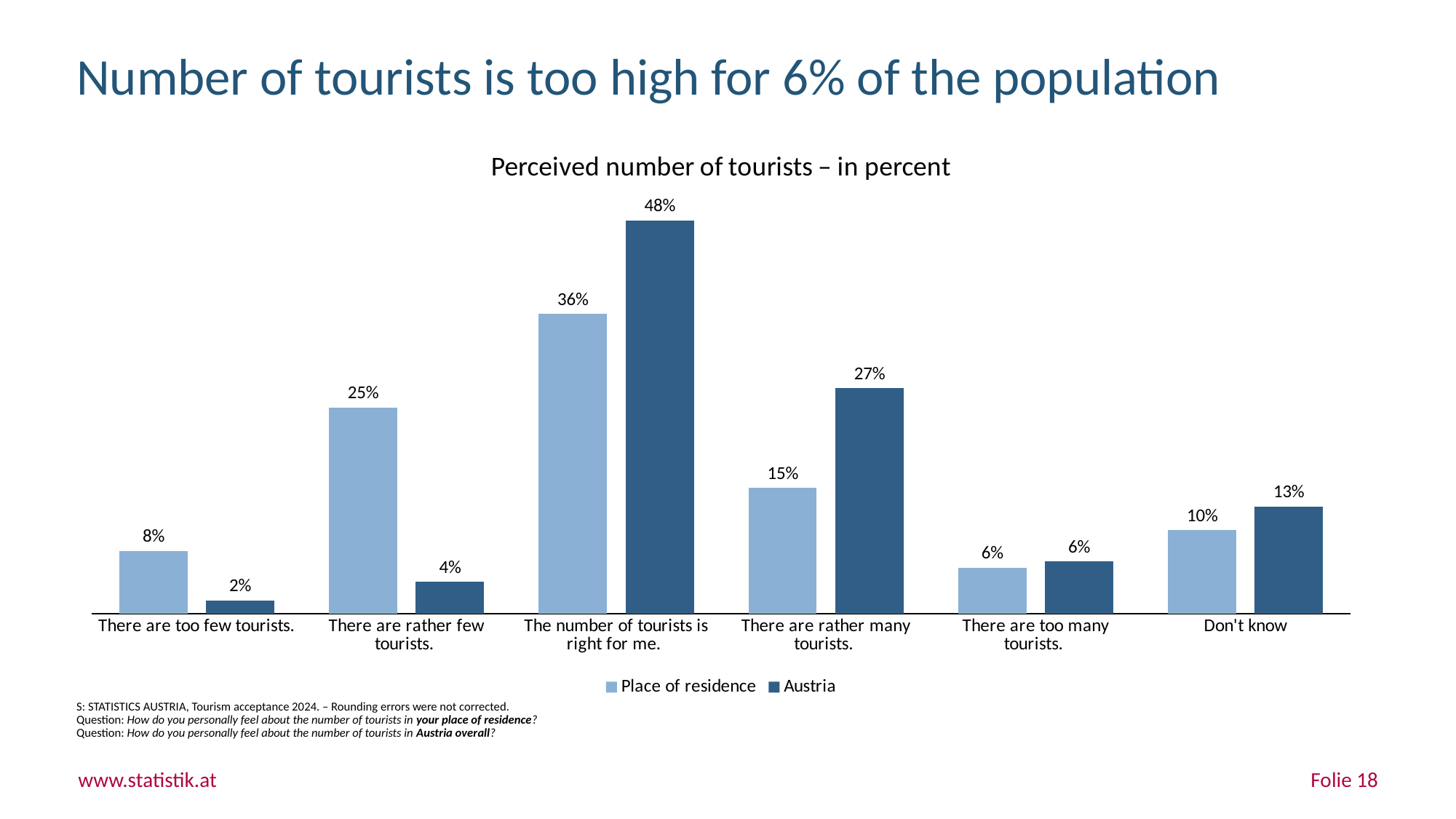
Which category has the lowest value for the "Place of residence" series? There are too many tourists. Which is larger for "There are rather few tourists.": the "Place of residence" value or the "Austria" value? Place of residence Which category has the highest value for the "Austria" series? The number of tourists is right for me. What kind of chart is shown on the slide? Bar chart What is the value for "Austria" in the category "There are rather many tourists."? 27% What is the value for "Austria" in the category "There are too few tourists."? 2% What is the difference between the "Austria" and "Place of residence" values for "Don't know"? 3% How many categories are shown on the x axis? 6 How many series does the legend list? 2 What is the value for "Place of residence" in the category "The number of tourists is right for me."? 36% What is the title of the chart? Perceived number of tourists – in percent What is the difference between the "Austria" and "Place of residence" values for "The number of tourists is right for me."? 12%